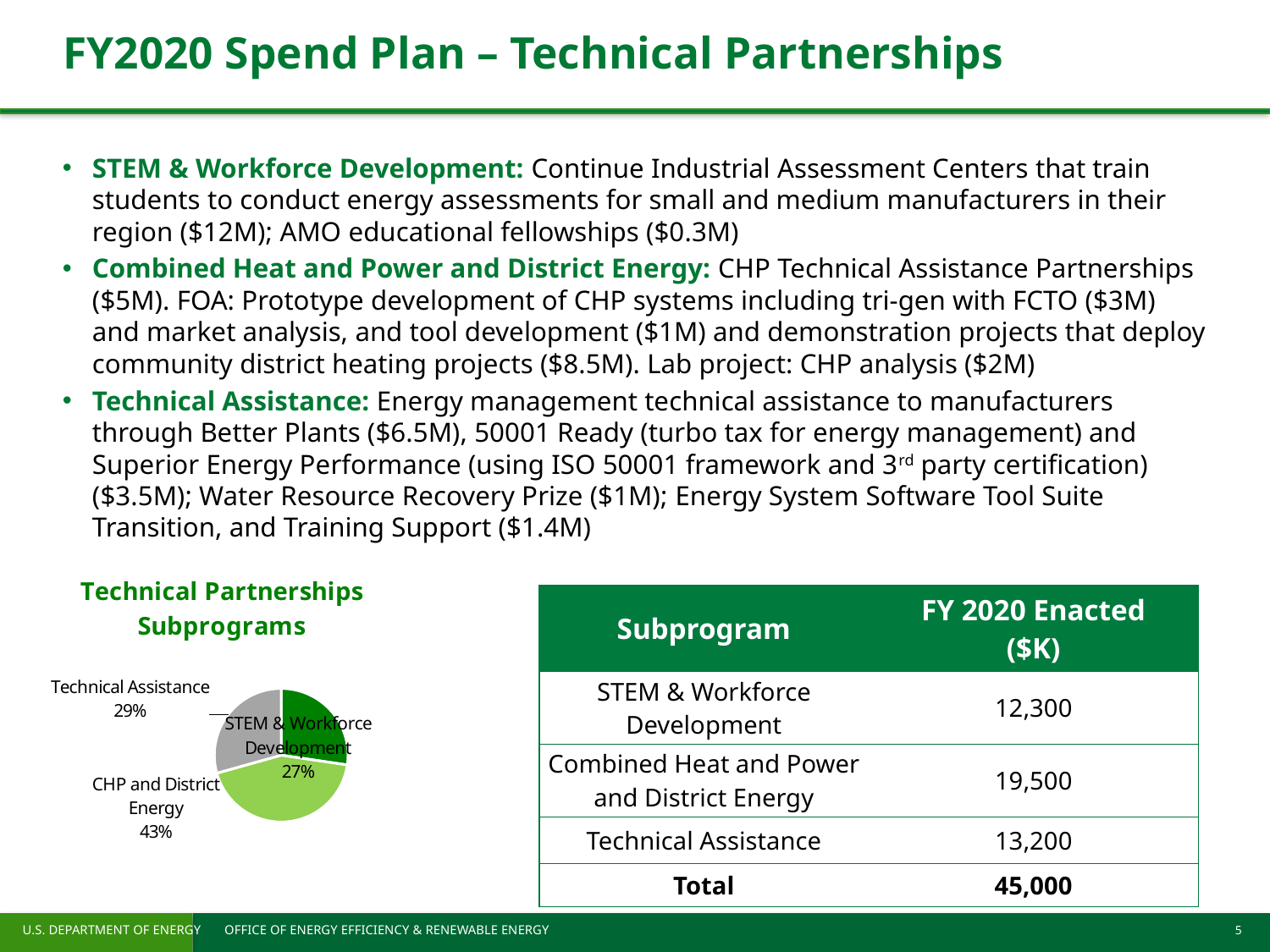
Which subprogram has the smallest slice in the Technical Partnerships Subprograms pie chart? STEM & Workforce Development What share of the Technical Partnerships Subprograms pie is STEM & Workforce Development? 27% What share of the Technical Partnerships Subprograms pie is Technical Assistance? 29% In the Technical Partnerships Subprograms pie chart, how many percentage points larger is CHP and District Energy than Technical Assistance? 14 What share of the Technical Partnerships Subprograms pie is CHP and District Energy? 43% In the Technical Partnerships Subprograms pie chart, what colour is the Technical Assistance slice? grey In the Technical Partnerships Subprograms pie chart, how many percentage points larger is Technical Assistance than STEM & Workforce Development? 2 What is the title of the pie chart on the slide? Technical Partnerships Subprograms In the Technical Partnerships Subprograms pie chart, which is larger: CHP and District Energy or STEM & Workforce Development? CHP and District Energy What kind of chart is the Technical Partnerships Subprograms chart? pie chart Which subprogram has the largest slice in the Technical Partnerships Subprograms pie chart? CHP and District Energy How many slices does the Technical Partnerships Subprograms pie chart have? 3